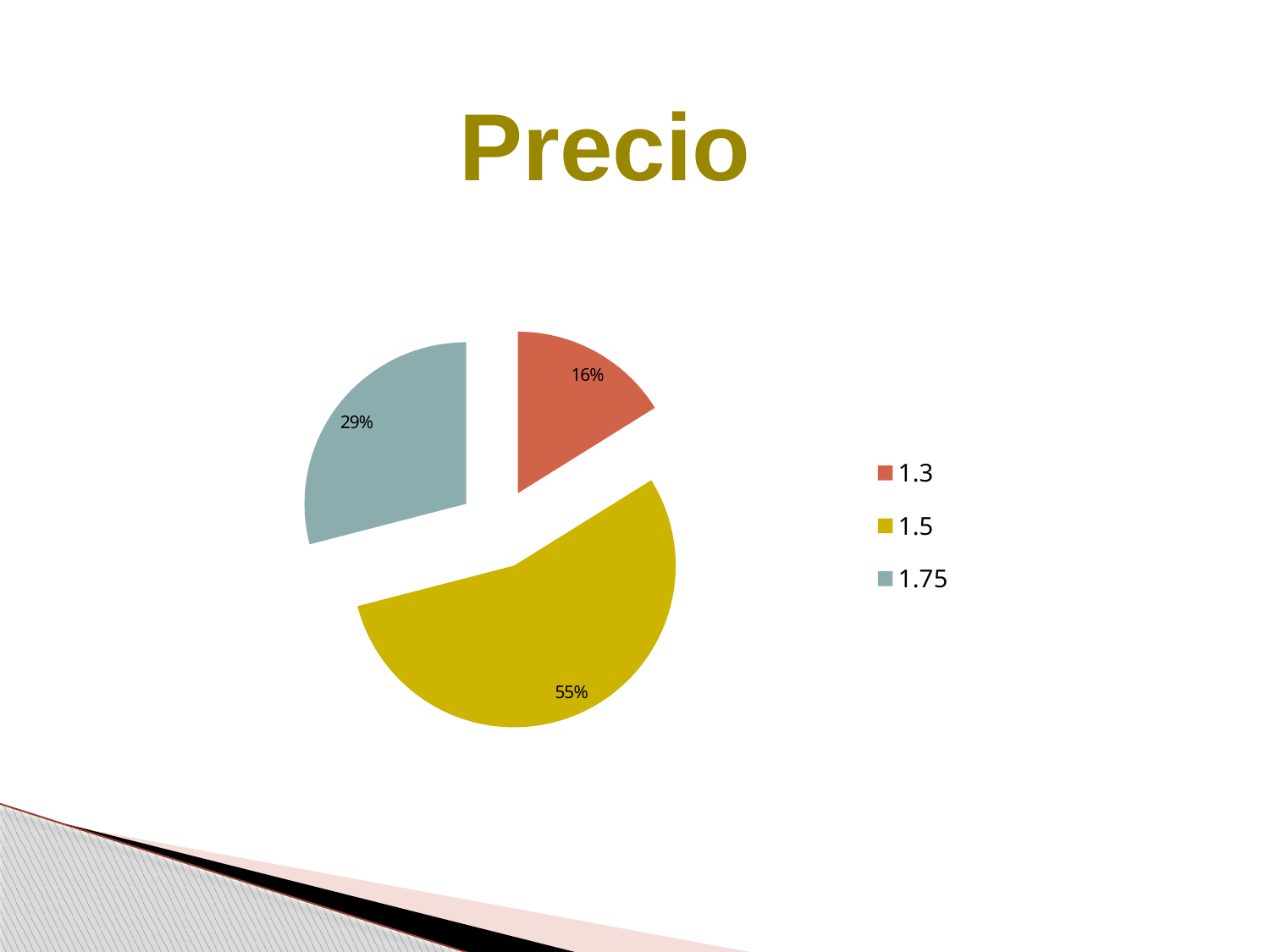
Which category has the smallest slice of the pie? 1.3 What colour is the slice for 1.75? grey-blue What share of the pie does the 1.3 slice represent? 16% What is the title of the slide? Precio Which category has the largest slice of the pie? 1.5 What is the difference in percentage points between the 1.5 slice and the 1.75 slice? 26 What share of the pie does the 1.75 slice represent? 29% What share of the pie does the 1.5 slice represent? 55% How many entries does the legend list? 3 How many slices does the pie chart have? 3 Which slice is larger, 1.75 or 1.3? 1.75 What kind of chart is shown on the slide? pie chart